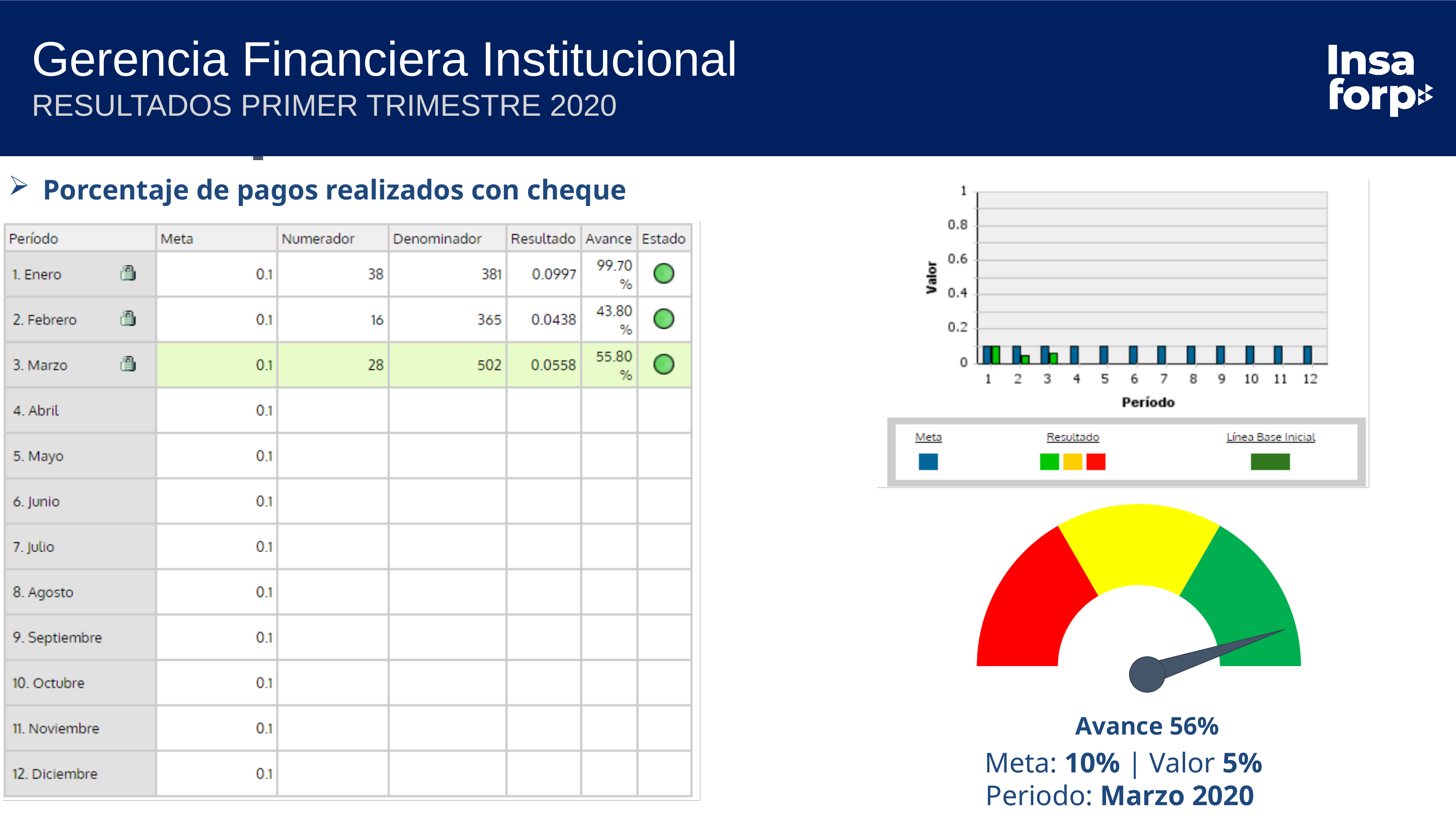
In the bar chart at the top right, which colour represents the Meta series? blue How many series does the legend of the bar chart at the top right list? 3 In the bar chart at the top right, is the Resultado bar for period 1 larger or smaller than the Resultado bar for period 2? larger What Avance value is shown below the gauge chart at the bottom right? 56% In the bar chart at the top right, what is the label of the y axis? Valor In the bar chart at the top right, is the Resultado value for period 2 greater or less than 0.1? less What Meta value is shown below the gauge chart at the bottom right? 10% In the bar chart at the top right, how many periods are shown on the x axis? 12 In the bar chart at the top right, which period has the highest Resultado bar? 1 In the bar chart at the top right, is the Meta value for period 1 greater or less than 0.2? less What kind of chart is the chart at the top right of the slide (Valor vs Período)? bar chart In the bar chart at the top right, do the Meta bars rise, fall or stay constant across periods 1 to 12? stay constant